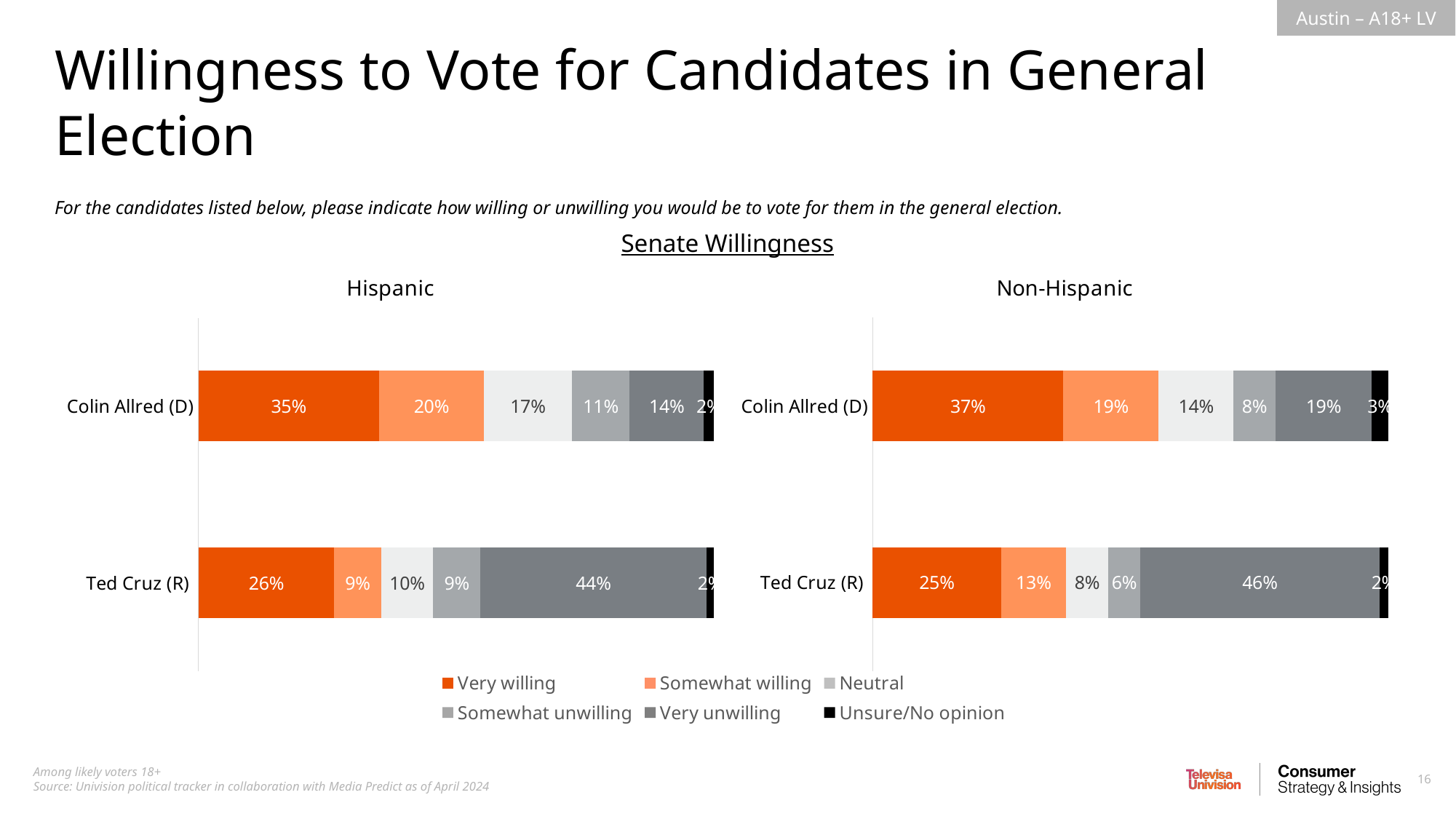
In the Hispanic chart, what percentage of respondents are somewhat willing to vote for Ted Cruz (R)? 9% In the Non-Hispanic chart, what percentage of respondents are neutral about voting for Colin Allred (D)? 14% In the Hispanic chart, what percentage of respondents are very willing to vote for Colin Allred (D)? 35% In the Non-Hispanic chart, is the somewhat willing percentage larger for Colin Allred (D) or Ted Cruz (R)? Colin Allred (D) What kind of chart is the Non-Hispanic chart? Stacked bar chart In the Non-Hispanic chart, which candidate has the lower very willing percentage? Ted Cruz (R) How many candidates are shown in the Hispanic chart? 2 How many series does the legend list? 6 In the Hispanic chart, what is the difference between the very willing percentages for Colin Allred (D) and Ted Cruz (R)? 9% In the Hispanic chart, which candidate has the higher very unwilling percentage? Ted Cruz (R) In the Non-Hispanic chart, what percentage of respondents are very unwilling to vote for Ted Cruz (R)? 46% In the Hispanic chart, what is the combined very willing and somewhat willing percentage for Colin Allred (D)? 55%